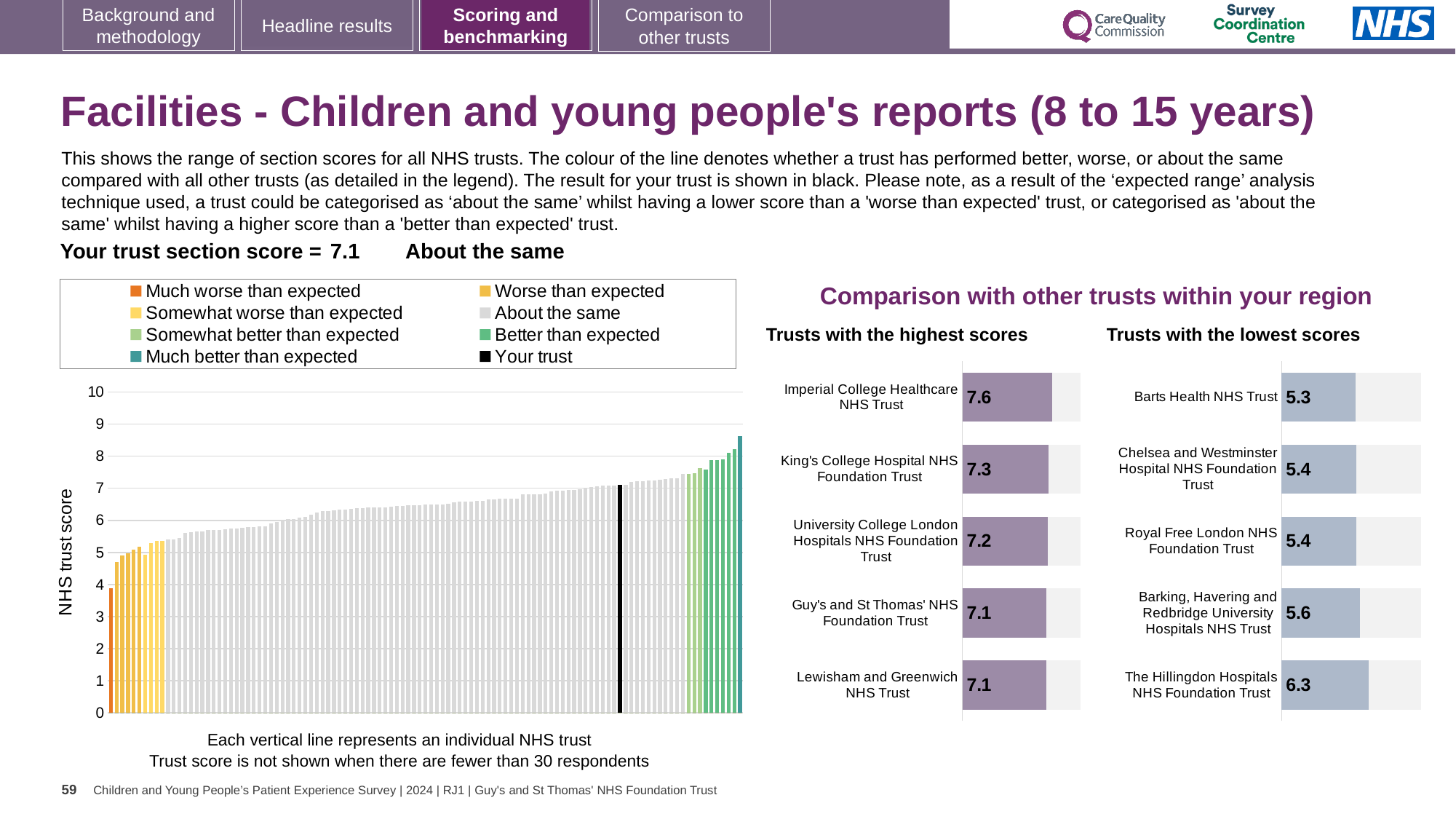
How many trusts are listed in the 'Trusts with the lowest scores' chart? 5 In the 'Trusts with the highest scores' chart, what is the difference between the scores of Imperial College Healthcare NHS Trust and King's College Hospital NHS Foundation Trust? 0.3 In the 'Trusts with the lowest scores' chart, what is the score for The Hillingdon Hospitals NHS Foundation Trust? 6.3 In the 'Trusts with the lowest scores' chart, what is the difference between the scores of The Hillingdon Hospitals NHS Foundation Trust and Barts Health NHS Trust? 1.0 In the 'Trusts with the highest scores' chart, what is the score for Imperial College Healthcare NHS Trust? 7.6 In the 'Trusts with the highest scores' chart, which trust has the highest score? Imperial College Healthcare NHS Trust What kind of chart is the main chart on the left showing the range of section scores? Bar chart In the main chart on the left showing the range of section scores, is the value of the tallest bar greater or less than 8? greater How many entries does the legend of the main chart on the left list? 8 In the 'Trusts with the highest scores' chart, which has the higher score: King's College Hospital NHS Foundation Trust or University College London Hospitals NHS Foundation Trust? King's College Hospital NHS Foundation Trust In the 'Trusts with the lowest scores' chart, which trust has the lowest score? Barts Health NHS Trust In the main chart on the left showing the range of section scores, is the value of the shortest bar greater or less than 5? less